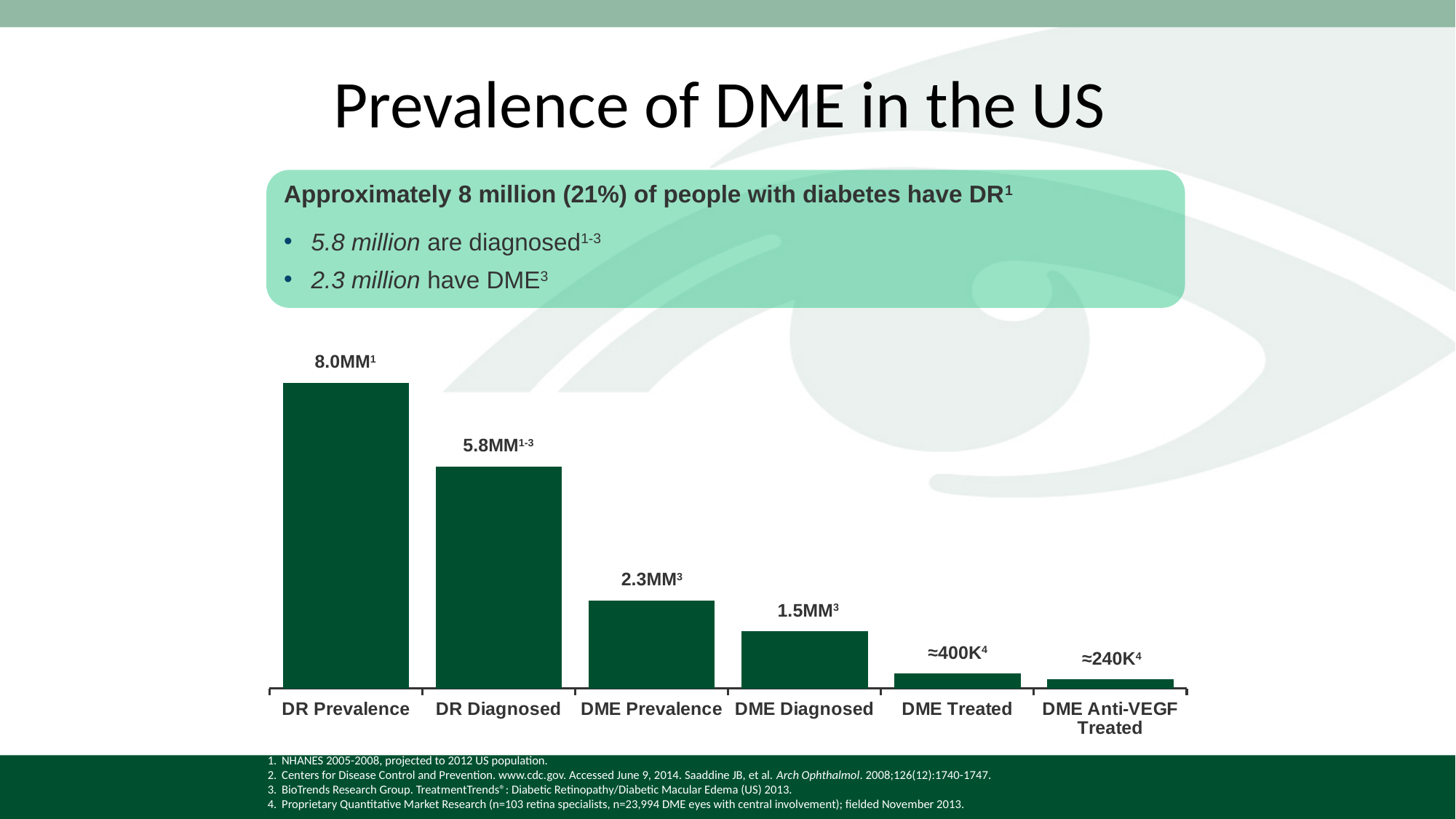
Do the values rise or fall from left to right across the categories? Fall What kind of chart is shown on the slide? Bar chart Which category has the highest value? DR Prevalence Which is larger, DME Treated or DME Anti-VEGF Treated? DME Treated How many categories are shown in the chart? 6 What is the difference between DR Prevalence and DR Diagnosed? 2.2MM What is the difference between DME Prevalence and DME Diagnosed? 0.8MM What is the value shown for DME Prevalence? 2.3MM What is the value shown for DR Prevalence? 8.0MM What is the value shown for DME Diagnosed? 1.5MM Which category has the lowest value? DME Anti-VEGF Treated What is the value shown for DR Diagnosed? 5.8MM